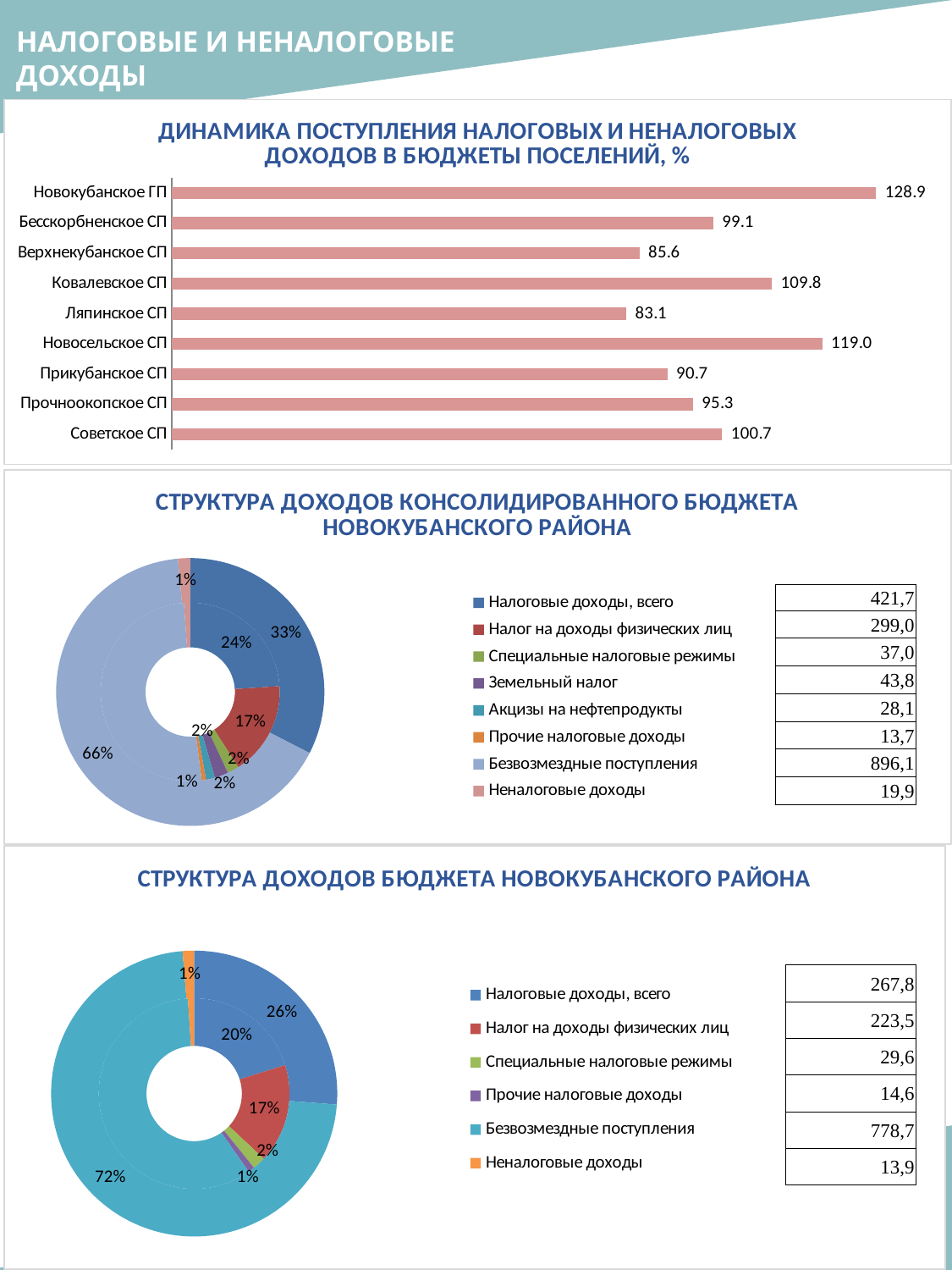
In the bar chart 'Динамика поступления налоговых и неналоговых доходов в бюджеты поселений, %', which settlement has the lowest value? Ляпинское СП In the chart 'Структура доходов бюджета Новокубанского района', what share does Налоговые доходы, всего have? 26% In the chart 'Структура доходов бюджета Новокубанского района', what value is listed for Безвозмездные поступления? 778,7 In the bar chart 'Динамика поступления налоговых и неналоговых доходов в бюджеты поселений, %', what is the value for Ковалевское СП? 109.8 In the bar chart 'Динамика поступления налоговых и неналоговых доходов в бюджеты поселений, %', which settlement has the highest value? Новокубанское ГП How many settlements are shown in the bar chart 'Динамика поступления налоговых и неналоговых доходов в бюджеты поселений, %'? 9 What type of chart is 'Динамика поступления налоговых и неналоговых доходов в бюджеты поселений, %'? Bar chart In the chart 'Структура доходов консолидированного бюджета Новокубанского района', what share does Безвозмездные поступления have? 66% In the chart 'Структура доходов консолидированного бюджета Новокубанского района', what value is listed for Земельный налог? 43,8 In the bar chart 'Динамика поступления налоговых и неналоговых доходов в бюджеты поселений, %', what is the difference between the values for Новосельское СП and Прикубанское СП? 28.3 How many entries does the legend of the chart 'Структура доходов консолидированного бюджета Новокубанского района' list? 8 In the bar chart 'Динамика поступления налоговых и неналоговых доходов в бюджеты поселений, %', which is larger: Бесскорбненское СП or Советское СП? Советское СП